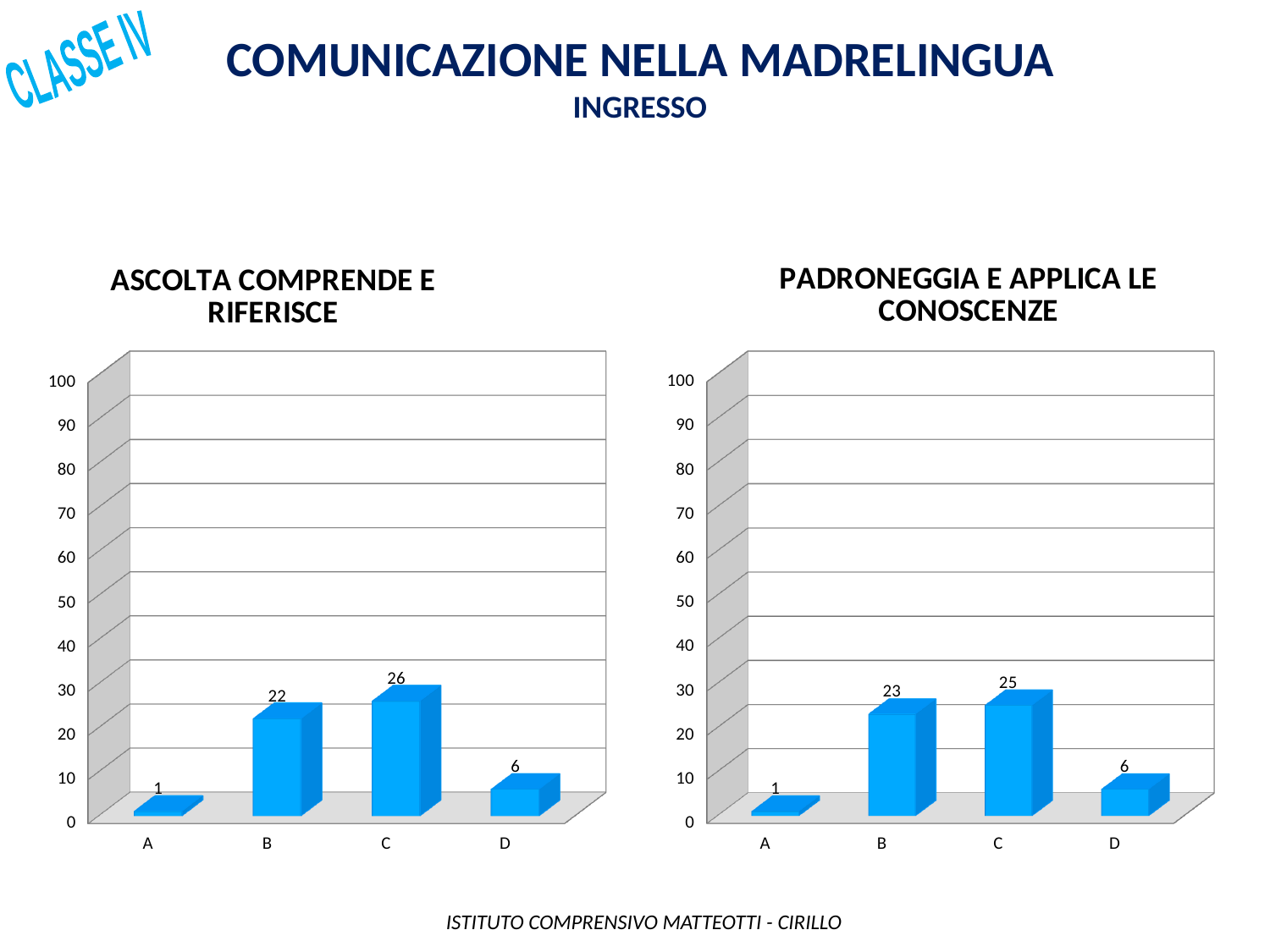
In the chart titled "ASCOLTA COMPRENDE E RIFERISCE", what is the difference between the values for B and D? 16 What kind of chart is the chart titled "PADRONEGGIA E APPLICA LE CONOSCENZE"? Bar chart In the chart titled "PADRONEGGIA E APPLICA LE CONOSCENZE", what is the value for category B? 23 In the chart titled "PADRONEGGIA E APPLICA LE CONOSCENZE", is the value for C greater or less than 20? greater In the chart titled "PADRONEGGIA E APPLICA LE CONOSCENZE", what is the difference between the values for C and A? 24 In the chart titled "ASCOLTA COMPRENDE E RIFERISCE", which is larger, the value for B or the value for D? B In the chart titled "ASCOLTA COMPRENDE E RIFERISCE", what is the value for category A? 1 In the chart titled "ASCOLTA COMPRENDE E RIFERISCE", what is the value for category C? 26 In the chart titled "PADRONEGGIA E APPLICA LE CONOSCENZE", which category has the lowest value? A How many categories are shown in the chart titled "ASCOLTA COMPRENDE E RIFERISCE"? 4 What is the title of the chart on the right side of the slide? PADRONEGGIA E APPLICA LE CONOSCENZE In the chart titled "ASCOLTA COMPRENDE E RIFERISCE", which category has the highest value? C